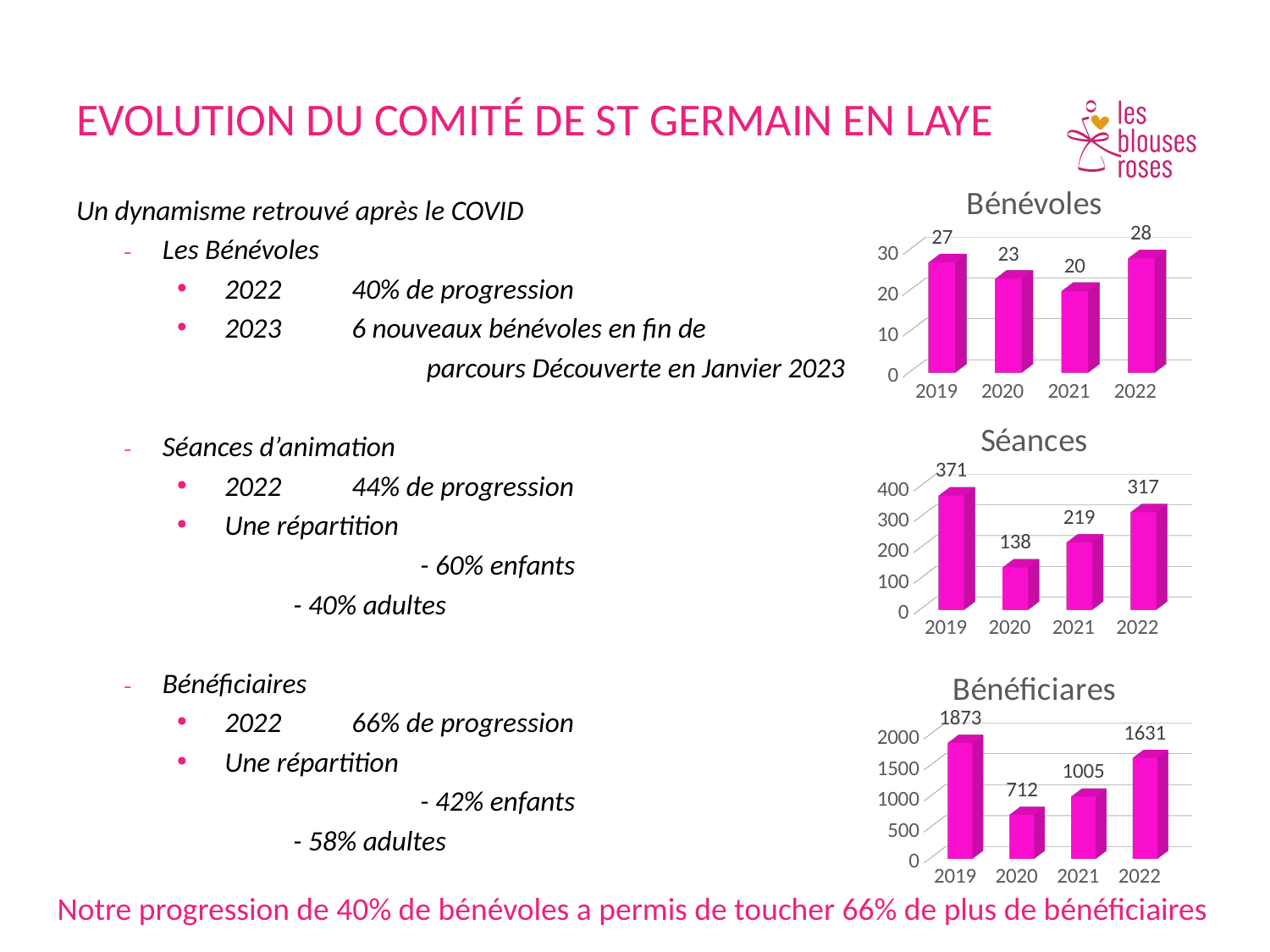
In the Bénévoles chart, which year has the highest value? 2022 In the Séances chart, which is larger, the value for 2019 or the value for 2022? 2019 In the Bénéficiaires chart, which year has the highest value? 2019 In the Séances chart, what is the value for 2020? 138 How many years are shown on the x axis of the Bénéficiaires chart? 4 In the Bénéficiaires chart, what is the difference between the 2022 and 2020 values? 919 In the Bénéficiaires chart, what is the value for 2021? 1005 In the Séances chart, what is the difference between the 2022 and 2021 values? 98 What kind of chart is the Séances chart? Bar chart In the Bénévoles chart, what is the value for 2021? 20 In the Bénévoles chart, what is the difference between the 2022 and 2021 values? 8 In the Séances chart, which year has the lowest value? 2020